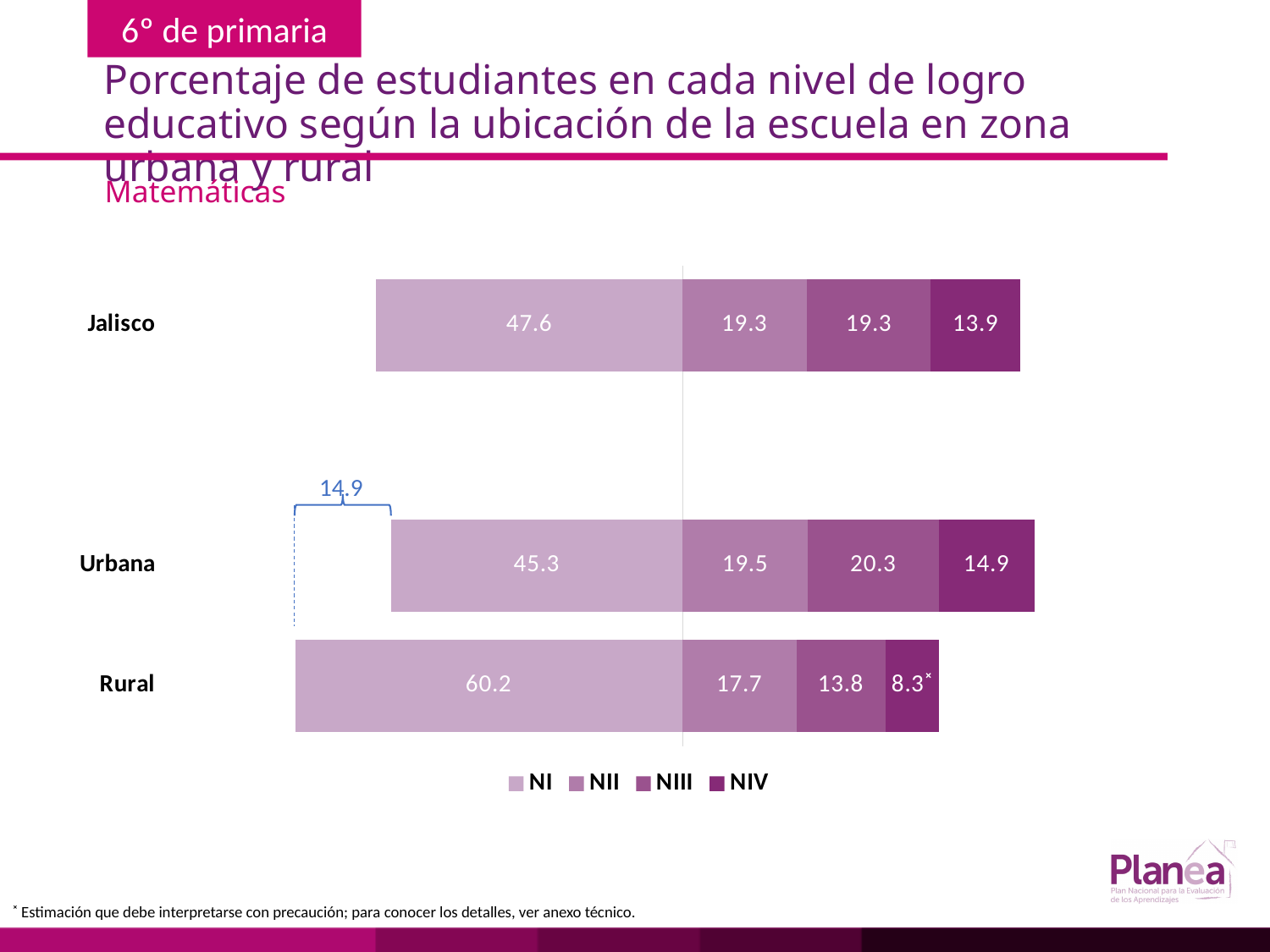
Which category has the lowest NIV value? Rural What is the value for NIV in the Urbana bar? 14.9 What is the value for NIII in the Jalisco bar? 19.3 What is the value for NI in the Rural bar? 60.2 How many series does the legend list? 4 How many categories (bars) are shown in the chart? 3 What is the difference between the NI value for Rural and the NI value for Urbana? 14.9 What is the value for NII in the Rural bar? 17.7 Which category has the highest NI value? Rural What kind of chart is shown on the slide? Stacked bar chart What is the difference between the NIV value for Urbana and the NIV value for Rural? 6.6 Which is larger, the NIII value for Urbana or the NIII value for Rural? Urbana